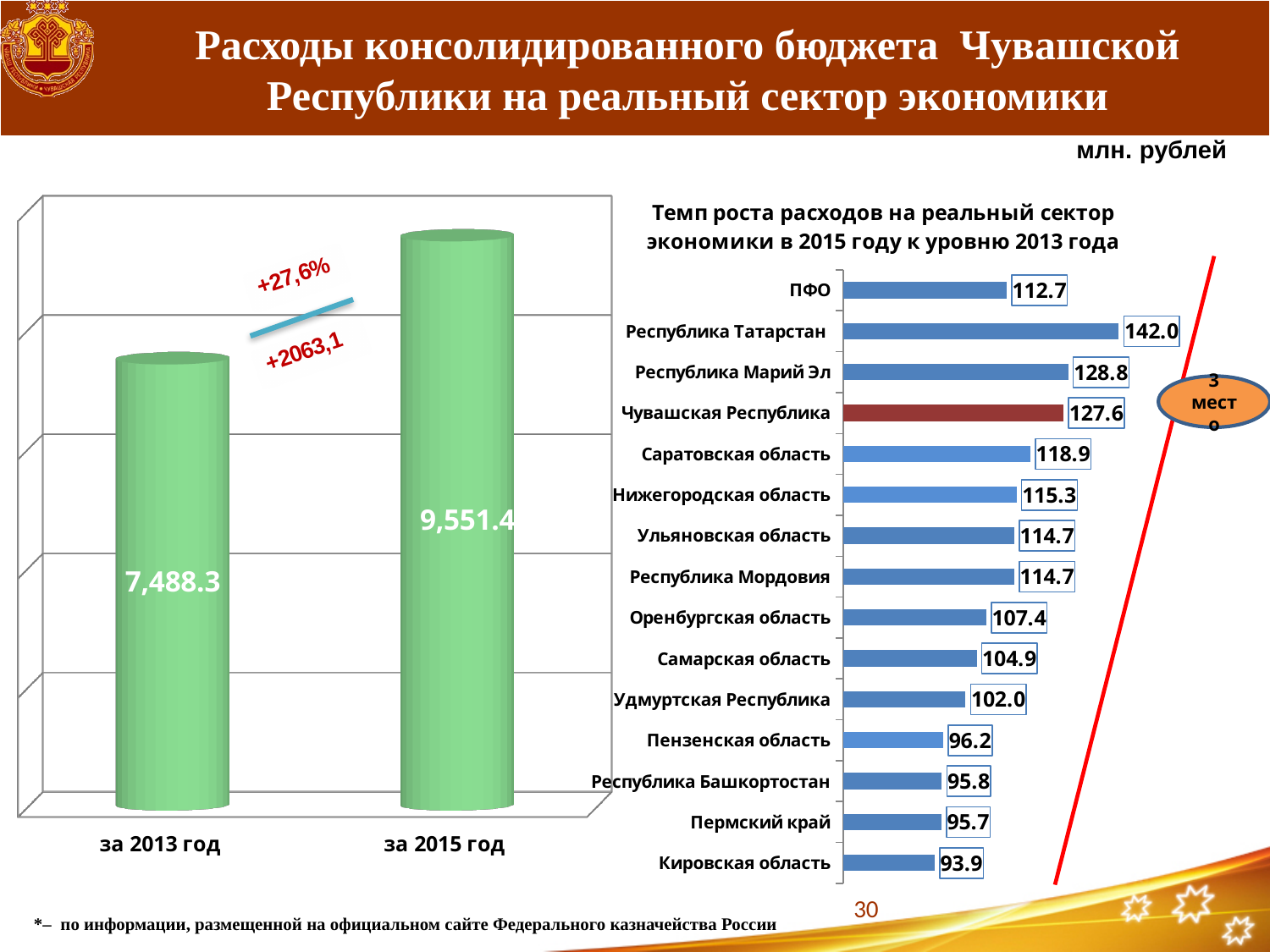
In the left chart, do the values rise or fall from 2013 to 2015? rise In the left chart, what is the difference between the 2015 and 2013 values? 2,063.1 In the chart titled 'Темп роста расходов на реальный сектор экономики в 2015 году к уровню 2013 года', how many categories are shown? 15 In the chart titled 'Темп роста расходов на реальный сектор экономики в 2015 году к уровню 2013 года', what is the value for ПФО? 112.7 In the left chart, what is the value for за 2013 год? 7,488.3 In the chart titled 'Темп роста расходов на реальный сектор экономики в 2015 году к уровню 2013 года', what is the value for Чувашская Республика? 127.6 What kind of chart is the left chart? bar chart In the chart titled 'Темп роста расходов на реальный сектор экономики в 2015 году к уровню 2013 года', which is larger: Саратовская область or Самарская область? Саратовская область In the chart titled 'Темп роста расходов на реальный сектор экономики в 2015 году к уровню 2013 года', what is the difference between Республика Татарстан and Чувашская Республика? 14.4 In the left chart, what is the value for за 2015 год? 9,551.4 In the chart titled 'Темп роста расходов на реальный сектор экономики в 2015 году к уровню 2013 года', which category has the highest value? Республика Татарстан In the chart titled 'Темп роста расходов на реальный сектор экономики в 2015 году к уровню 2013 года', which category has the lowest value? Кировская область